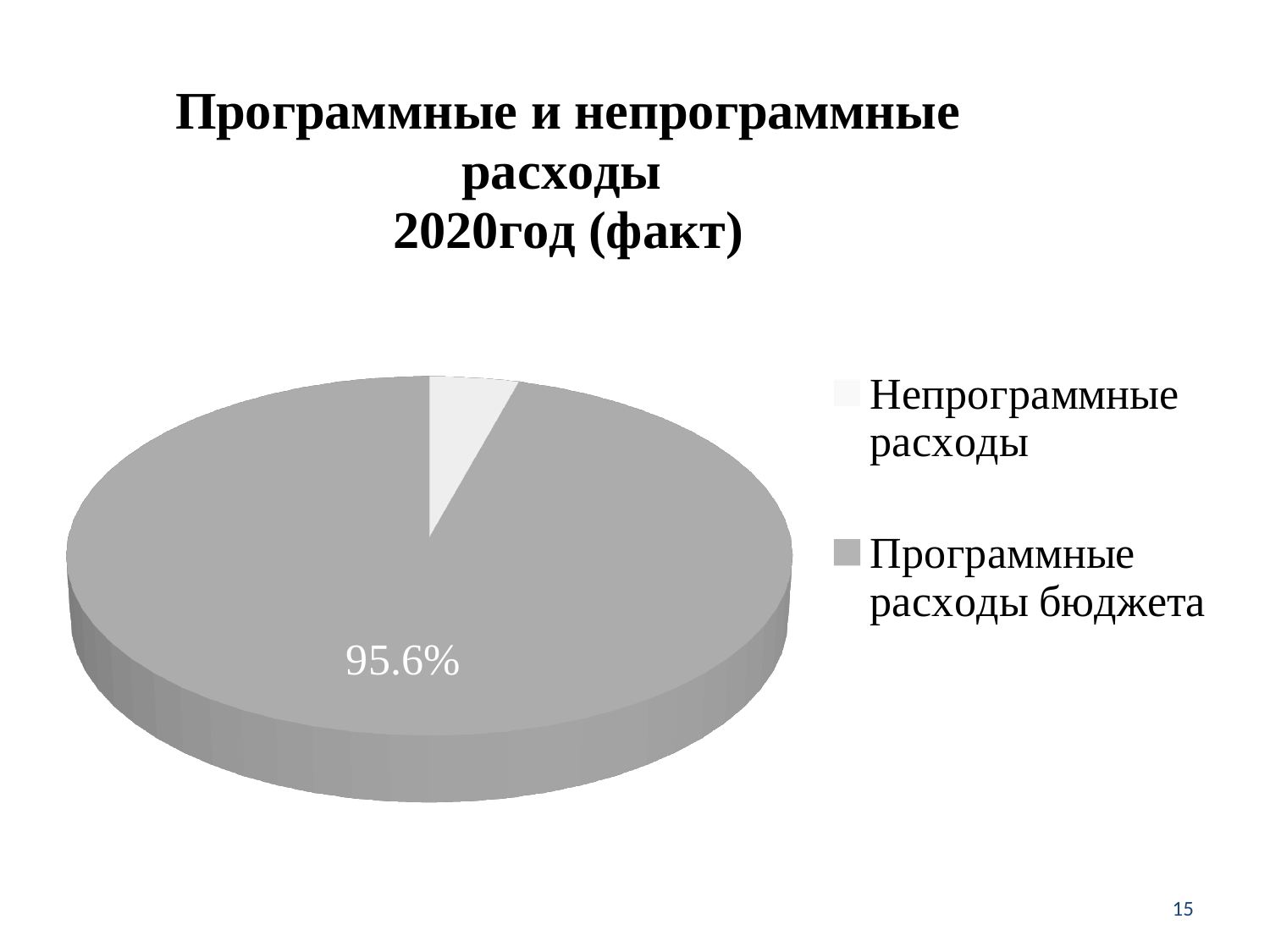
Which legend entry is shown in the lighter (white) colour? Непрограммные расходы Which slice of the pie is the largest? Программные расходы бюджета What value is printed on the "Программные расходы бюджета" slice? 95.6% How many slices does the pie chart have? 2 Which is larger: "Непрограммные расходы" or "Программные расходы бюджета"? Программные расходы бюджета What is the title of the chart? Программные и непрограммные расходы 2020год (факт) How many entries does the legend list? 2 What kind of chart is shown on the slide? Pie chart What share of the pie does "Программные расходы бюджета" have? 95.6% Which slice of the pie is the smallest? Непрограммные расходы